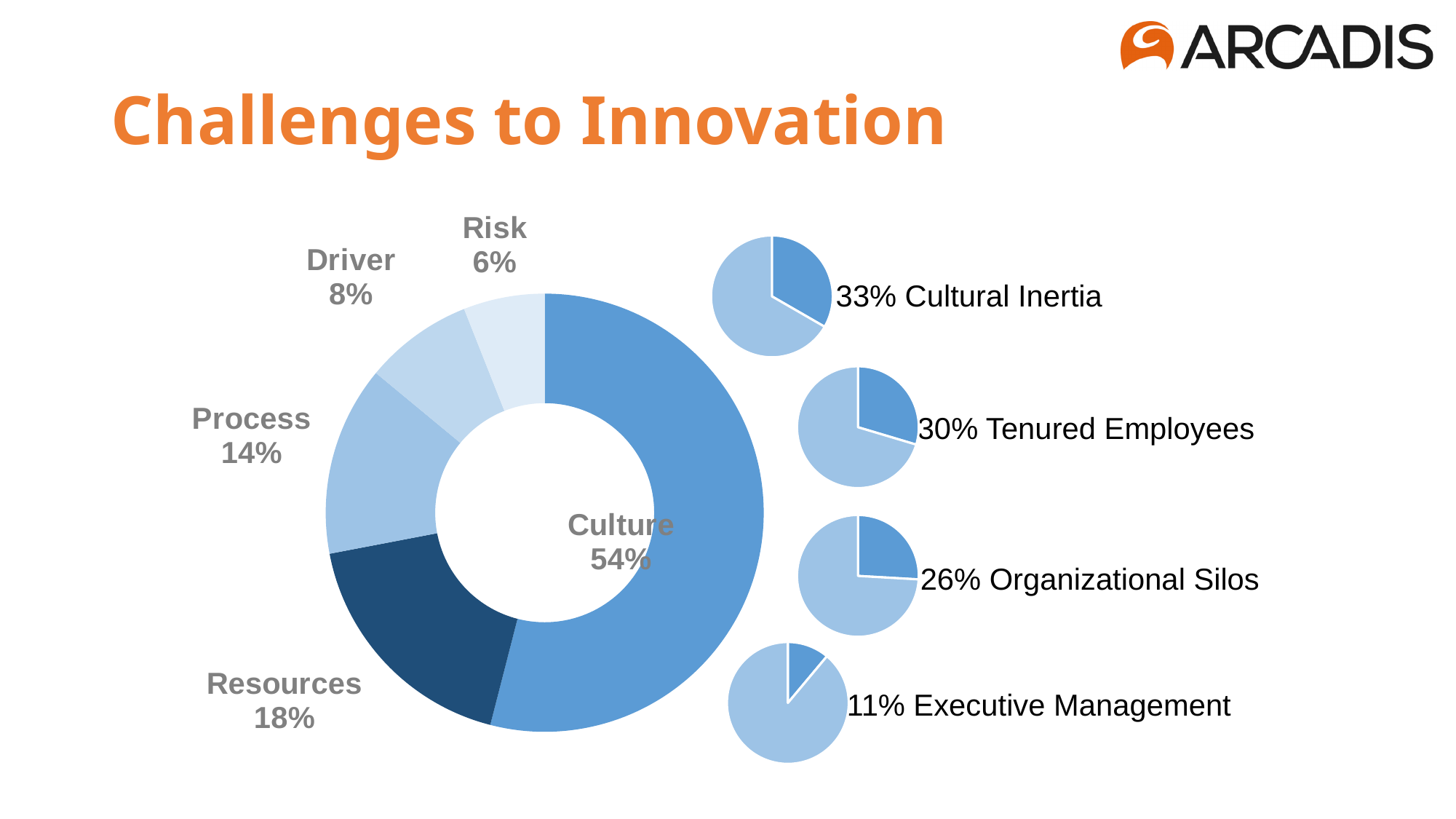
In the large donut chart, what is the difference between the Culture share and the Resources share? 36% How many categories are shown in the large donut chart? 5 In the large donut chart, what share is labelled for Resources? 18% In the large donut chart, which category has the smallest share? Risk In the small pie chart labelled Cultural Inertia, what percentage is shown? 33% In the large donut chart, what share is labelled for Process? 14% In the small pie chart labelled Executive Management, what percentage is shown? 11% In the large donut chart, which category has the largest share? Culture In the large donut chart, which is larger, the Driver share or the Process share? Process In the large donut chart, what share is labelled for Culture? 54% How many small pie charts are shown to the right of the large donut chart? 4 What kind of chart is the large chart on the left of the slide? Donut (pie) chart